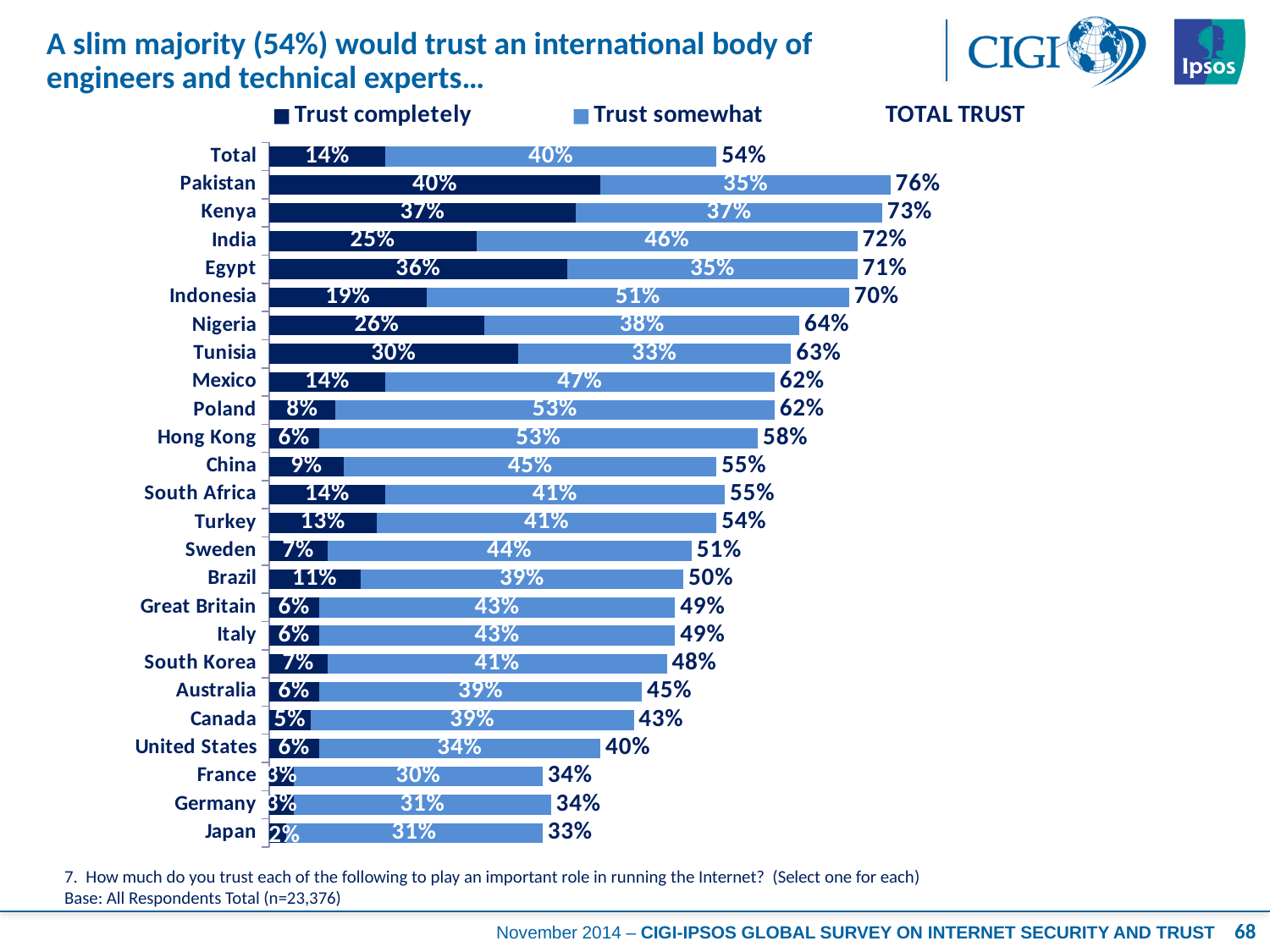
Which country has the lowest total trust value? Japan How many categories (rows) are plotted in the chart, including Total? 25 Which series is shown in the darker navy colour? Trust completely What is the total trust value shown for Mexico? 62% What percentage of respondents in Pakistan trust an international body of engineers and technical experts completely? 40% Which has a higher 'Trust completely' value, Egypt or Tunisia? Egypt What kind of chart is shown on the slide? Stacked bar chart How many series does the legend list? 2 What is the 'Trust somewhat' value for Indonesia? 51% Which country has the highest total trust value? Pakistan What is the difference between the total trust values for Kenya and the United States? 33% What is the total of the stacked bar for Canada? 43%